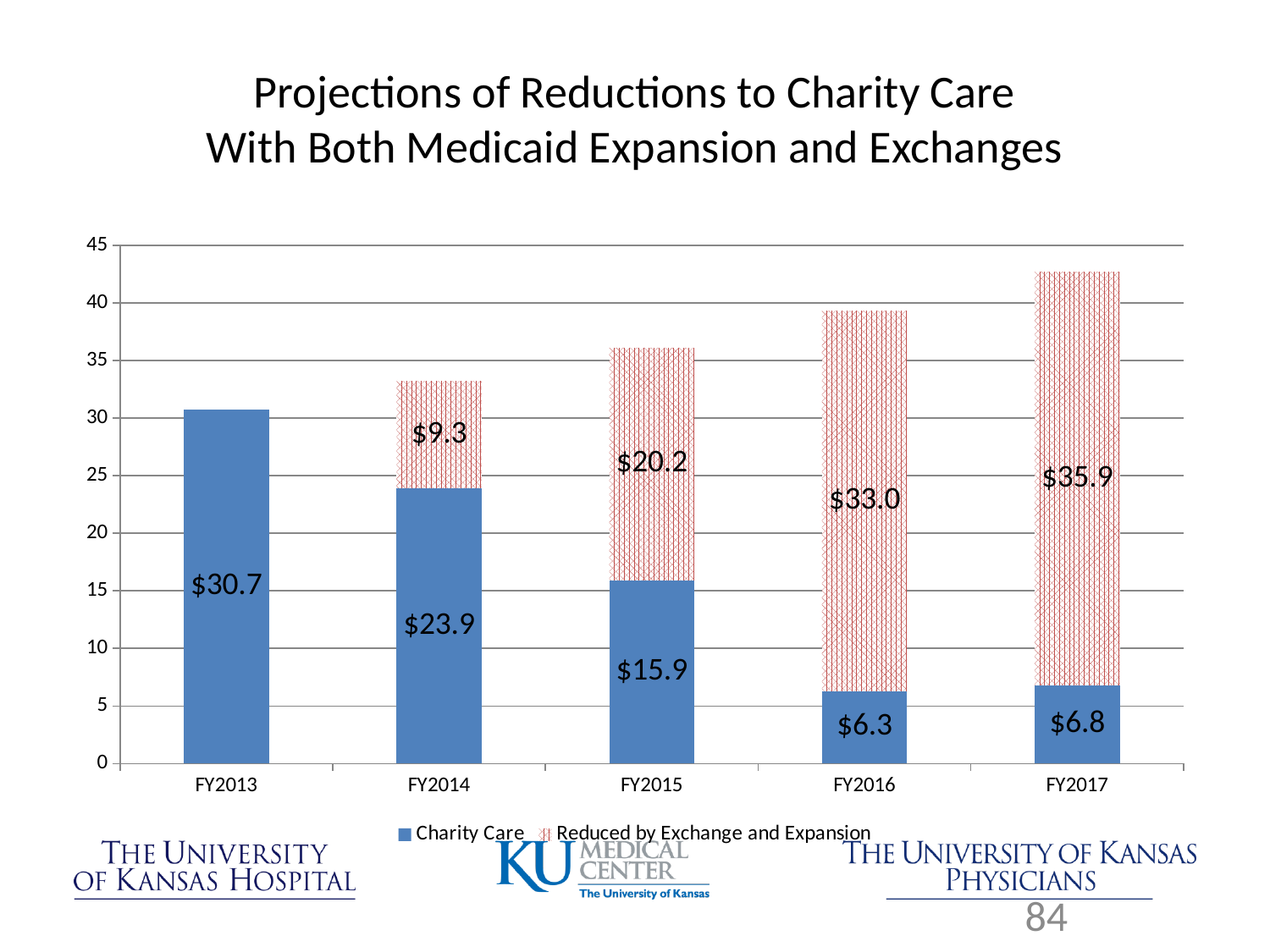
Which is larger for FY2015: the Charity Care value or the Reduced by Exchange and Expansion value? Reduced by Exchange and Expansion What is the Reduced by Exchange and Expansion value for FY2016? $33.0 How many series does the legend list? 2 Which fiscal year has the lowest Charity Care value? FY2016 What kind of chart is shown on the slide? Stacked bar chart What is the total of the stacked bar for FY2017? $42.7 Which fiscal year has the highest Charity Care value? FY2013 What is the Charity Care value for FY2015? $15.9 How many fiscal years are shown on the x axis? 5 What is the difference between the Charity Care values for FY2013 and FY2014? $6.8 Does the Charity Care value rise or fall from FY2013 to FY2016? Fall What is the Charity Care value for FY2013? $30.7